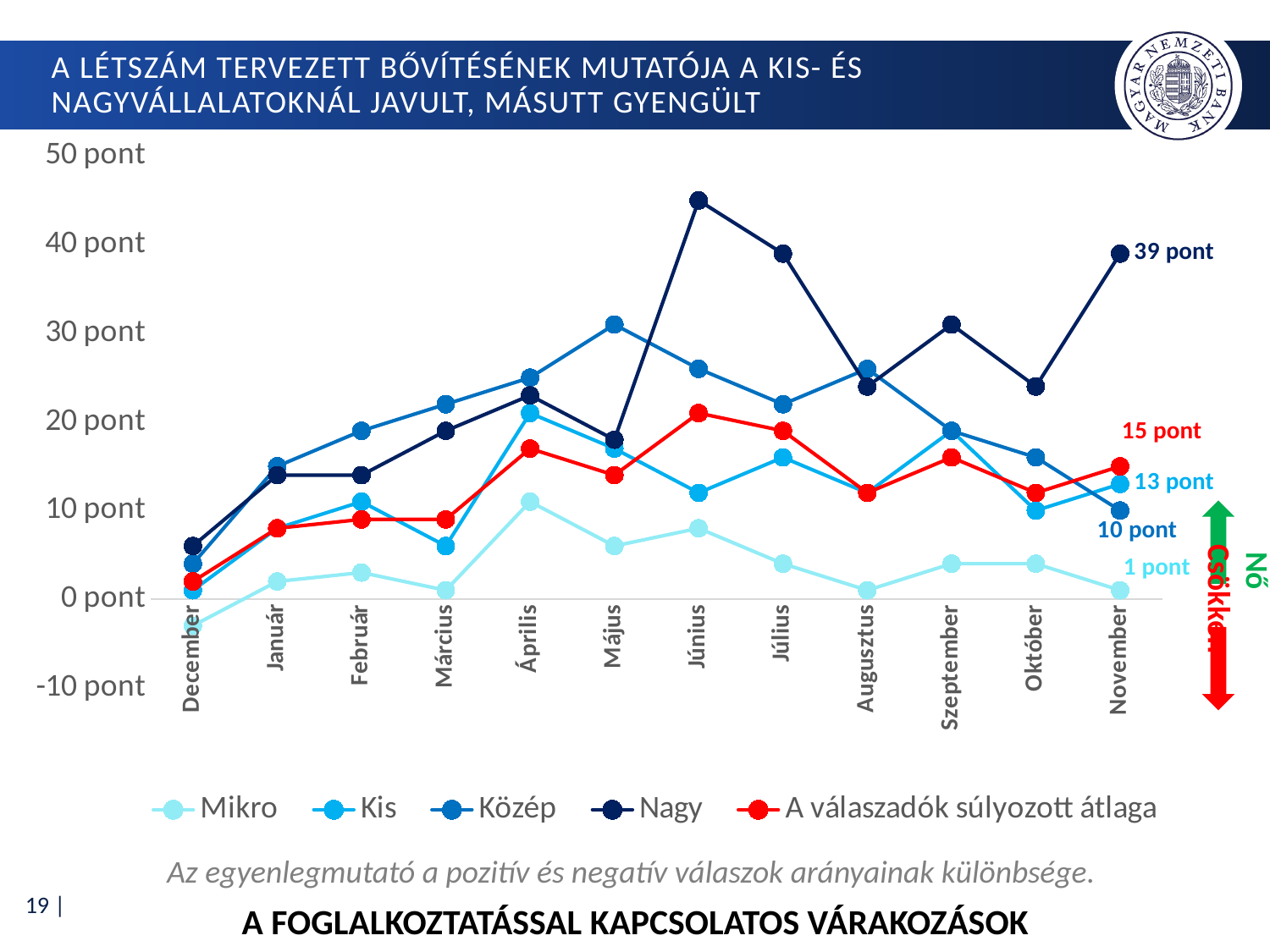
How many series does the legend list? 5 Which series has the lowest value in November? Mikro Which series has the highest value in November? Nagy What is the difference between the Nagy and Kis values in November? 26 pont What kind of chart is shown on the slide? line chart In November, which is larger: the Közép value or the Kis value? Kis Is the value for Nagy in Június greater or less than 40 pont? greater What is the value of the Mikro series in November? 1 pont What is the value of the Nagy series in November? 39 pont What is the value of 'A válaszadók súlyozott átlaga' in November? 15 pont How many months are shown on the x axis? 12 What is the value of the Kis series in November? 13 pont